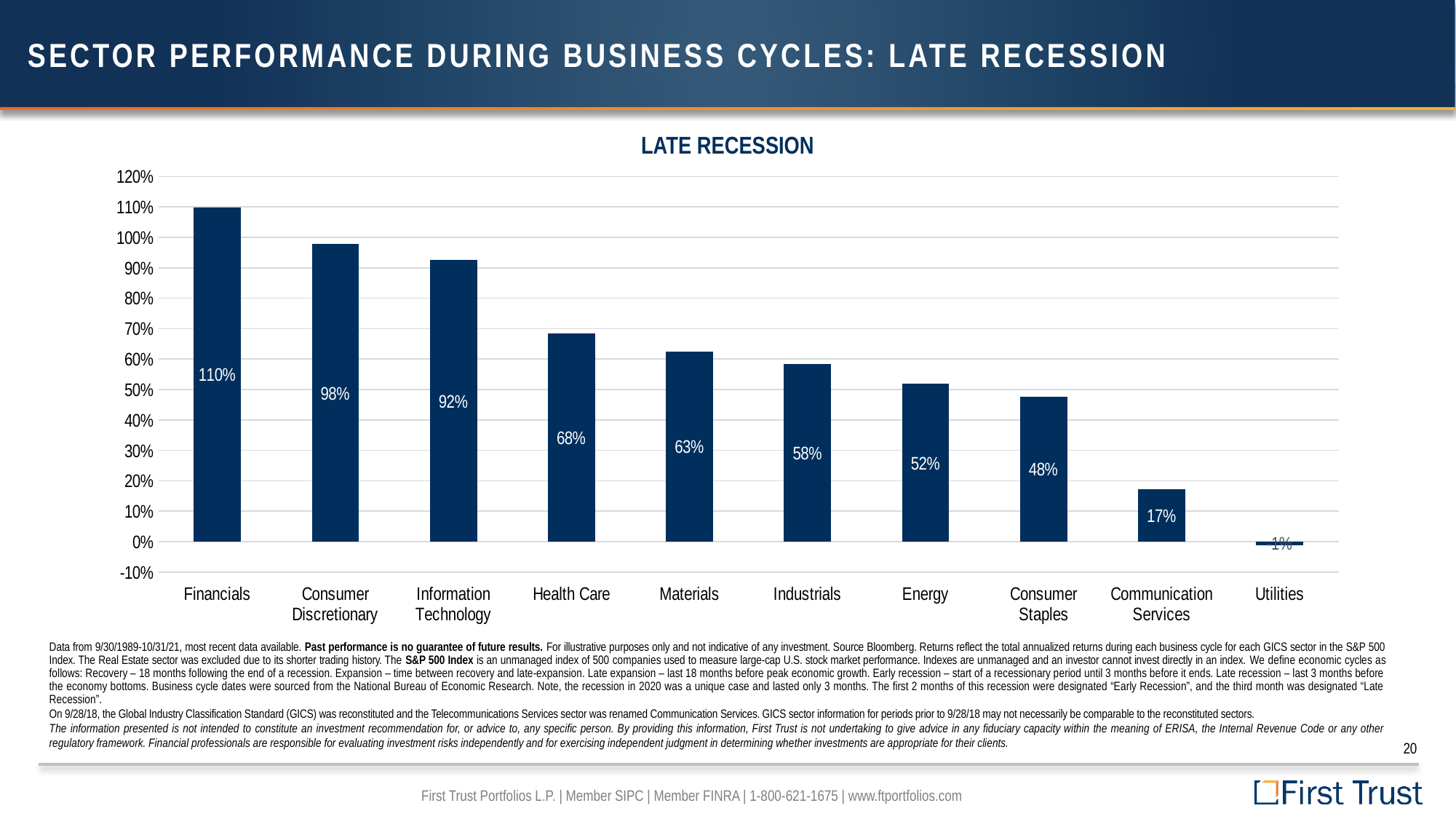
How many sectors are plotted in the chart? 10 What is the value for Consumer Staples? 48% What is the difference between the values for Health Care and Materials? 5% What type of chart is shown on the slide? bar chart Which sector has the lowest value? Utilities What is the value for Financials? 110% What is the value for Information Technology? 92% Is the value for Communication Services greater or less than 20%? less Do the values generally rise or fall moving from left to right across the sectors? fall Which is larger, the value for Energy or the value for Industrials? Industrials Which sector has the highest value? Financials What is the title of the chart? LATE RECESSION